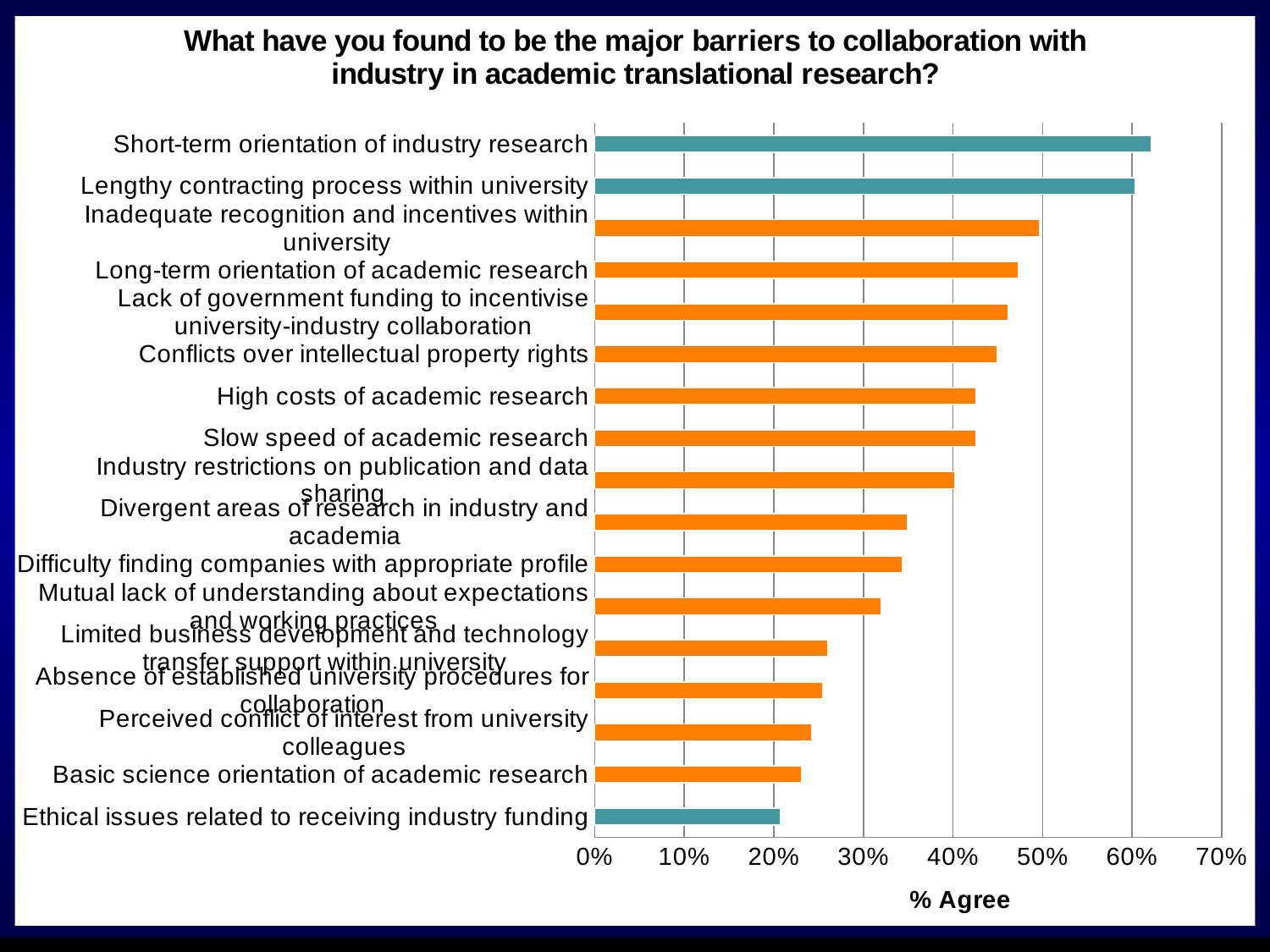
Which has a higher % Agree: 'Lengthy contracting process within university' or 'Basic science orientation of academic research'? Lengthy contracting process within university Is the value for 'Long-term orientation of academic research' greater or less than 50%? less Is the value for 'Conflicts over intellectual property rights' greater or less than 40%? greater How many barriers (categories) are plotted in the chart? 17 Is the value for 'Ethical issues related to receiving industry funding' greater or less than 30%? less Which has a higher % Agree: 'Conflicts over intellectual property rights' or 'Difficulty finding companies with appropriate profile'? Conflicts over intellectual property rights Which barrier is listed at the top of the chart? Short-term orientation of industry research What is the label on the horizontal axis of the chart? % Agree What kind of chart is shown on the slide? bar chart Do the bar values increase or decrease going from the top of the chart to the bottom? decrease